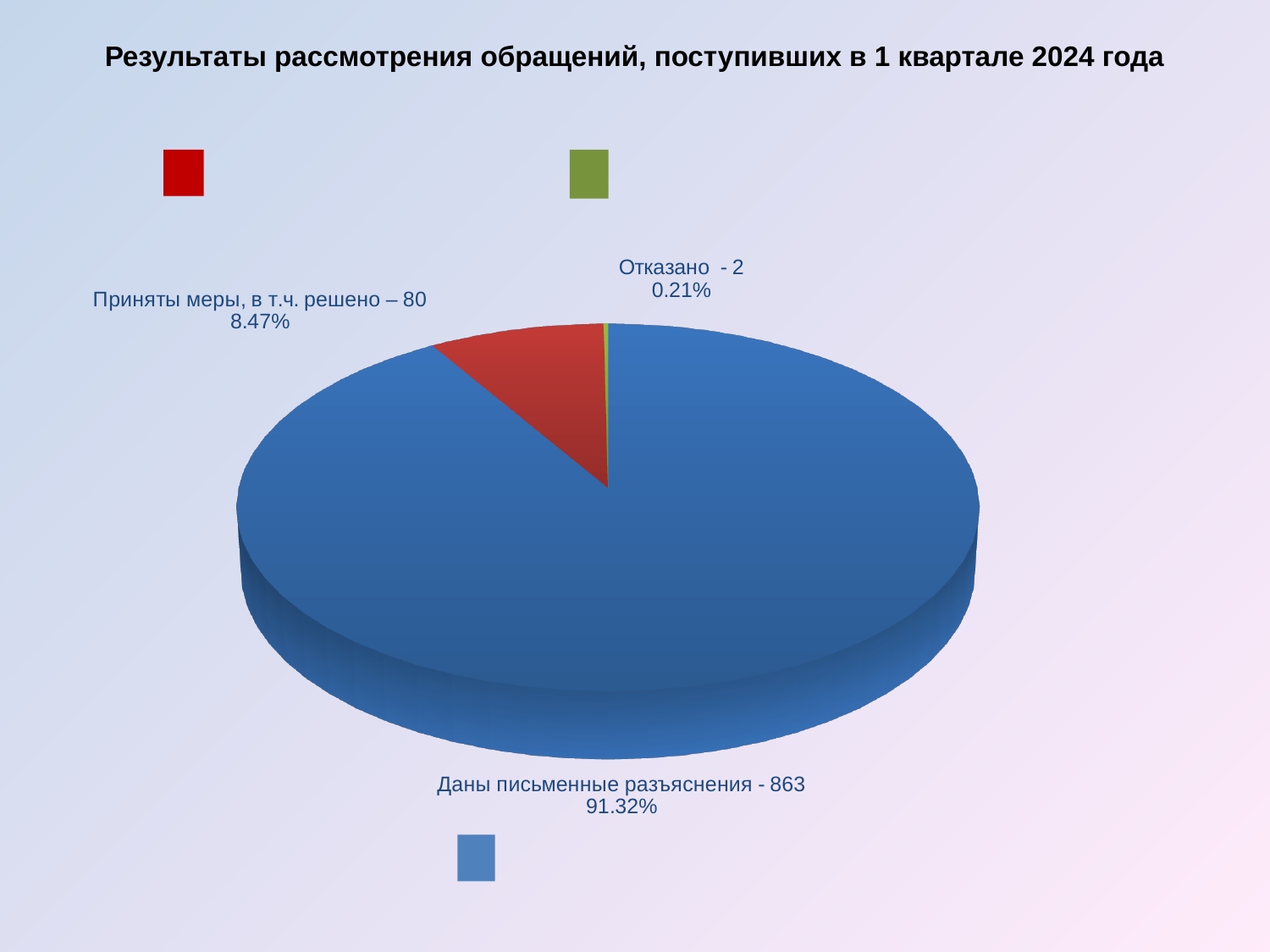
What is the value for "Отказано"? 2 What share of the pie does "Приняты меры, в т.ч. решено" represent? 8.47% What is the value for "Даны письменные разъяснения"? 863 What is the title of the chart? Результаты рассмотрения обращений, поступивших в 1 квартале 2024 года What is the difference between the values for "Даны письменные разъяснения" and "Приняты меры, в т.ч. решено"? 783 How many slices does the pie chart have? 3 What share of the pie does "Даны письменные разъяснения" represent? 91.32% Which category has the largest slice of the pie? Даны письменные разъяснения What type of chart is shown on the slide? Pie chart What share of the pie does "Отказано" represent? 0.21% What is the value for "Приняты меры, в т.ч. решено"? 80 Which category has the smallest slice of the pie? Отказано